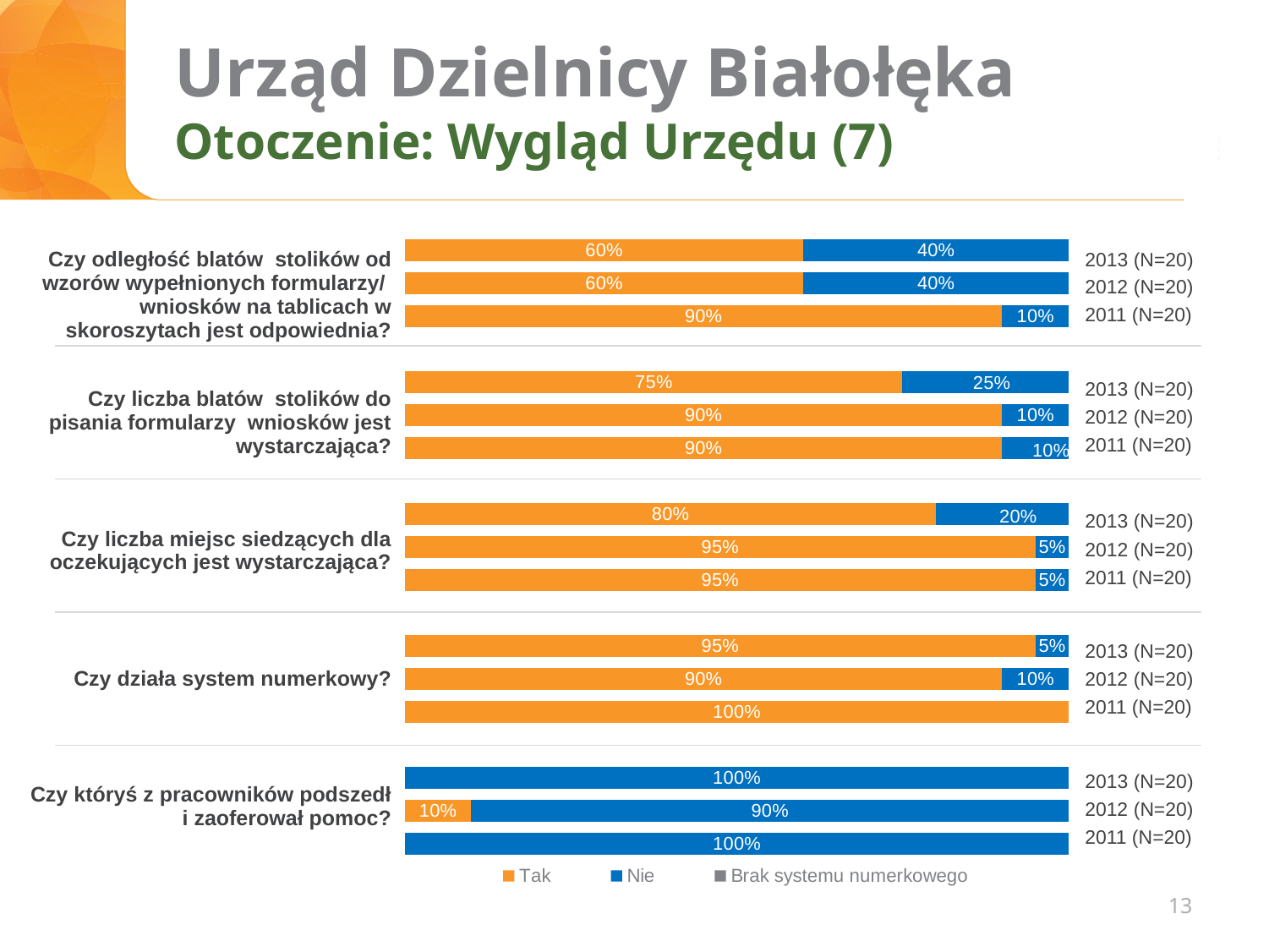
What is the 'Nie' value for 'Czy któryś z pracowników podszedł i zaoferował pomoc?' in 2012 (N=20)? 90% Which legend entry is shown in orange? Tak What is the 'Tak' value for 'Czy działa system numerkowy?' in 2011 (N=20)? 100% How many series does the legend list? 3 What is the 'Tak' value for 'Czy odległość blatów stolików od wzorów wypełnionych formularzy/ wniosków na tablicach w skoroszytach jest odpowiednia?' in 2011 (N=20)? 90% For 'Czy liczba miejsc siedzących dla oczekujących jest wystarczająca?', which year has the highest 'Nie' value? 2013 (N=20) For 'Czy odległość blatów stolików od wzorów wypełnionych formularzy/ wniosków na tablicach w skoroszytach jest odpowiednia?', what is the difference between the 'Tak' value in 2011 (N=20) and in 2013 (N=20)? 30% What is the 'Nie' value for 'Czy liczba blatów stolików do pisania formularzy wniosków jest wystarczająca?' in 2013 (N=20)? 25% What kind of chart is shown on the slide? stacked bar chart For 'Czy działa system numerkowy?', is the 'Tak' value in 2013 (N=20) larger or smaller than in 2012 (N=20)? larger What is the 'Tak' value for 'Czy liczba miejsc siedzących dla oczekujących jest wystarczająca?' in 2012 (N=20)? 95% How many years are shown for each question in the chart? 3